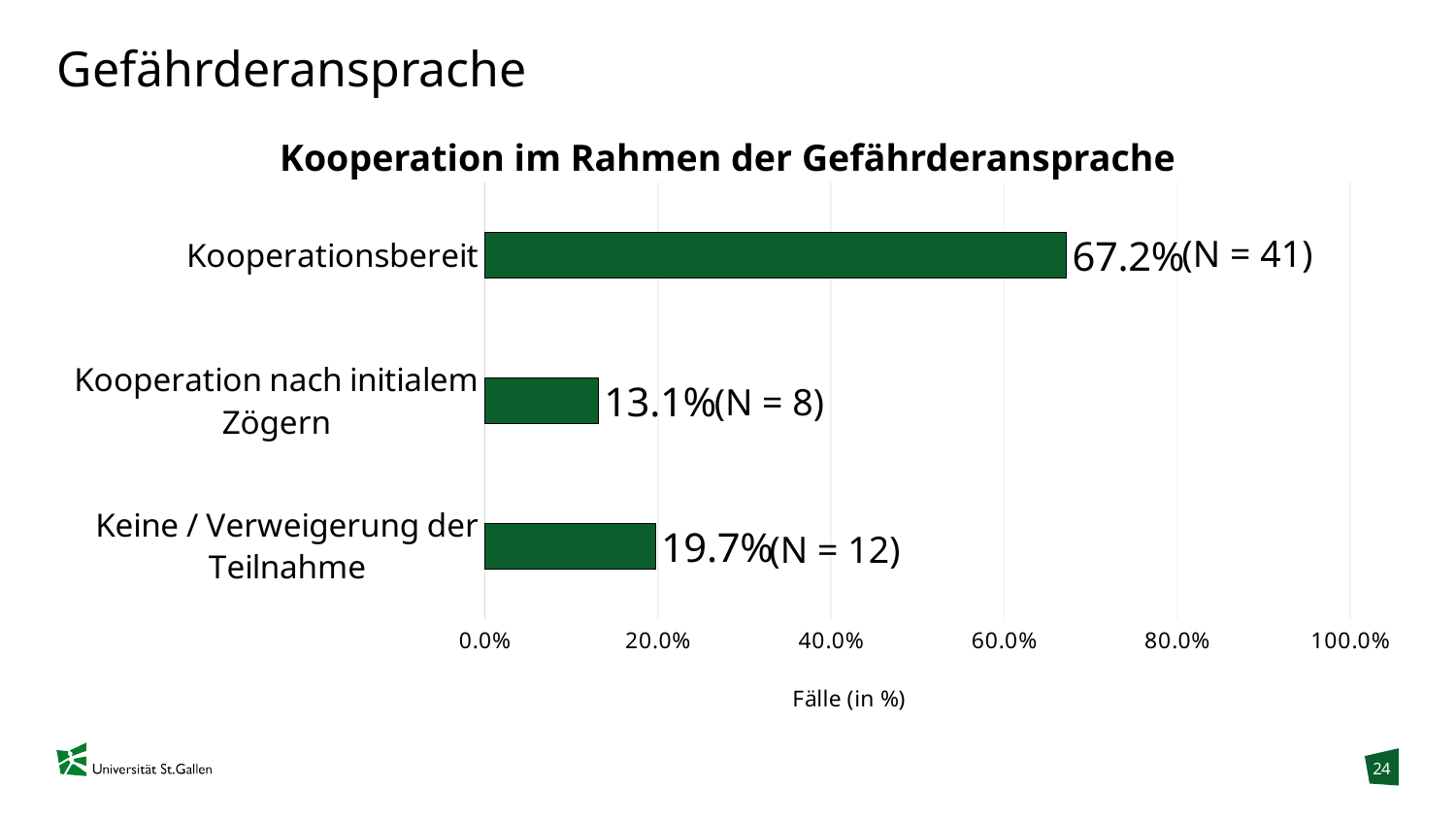
Which category has the highest value? Kooperationsbereit Which category has the lowest value? Kooperation nach initialem Zögern What is the value for Keine / Verweigerung der Teilnahme? 19.7% What kind of chart is shown on the slide? bar chart How many categories are shown in the chart? 3 What is the value for Kooperationsbereit? 67.2% Which is larger, the value for Keine / Verweigerung der Teilnahme or the value for Kooperation nach initialem Zögern? Keine / Verweigerung der Teilnahme Is the value for Kooperationsbereit greater or less than 60.0%? greater What is the difference between the values for Kooperationsbereit and Keine / Verweigerung der Teilnahme? 47.5% How many cases (N) are in the Kooperationsbereit category? 41 What is the title of the chart? Kooperation im Rahmen der Gefährderansprache What is the value for Kooperation nach initialem Zögern? 13.1%